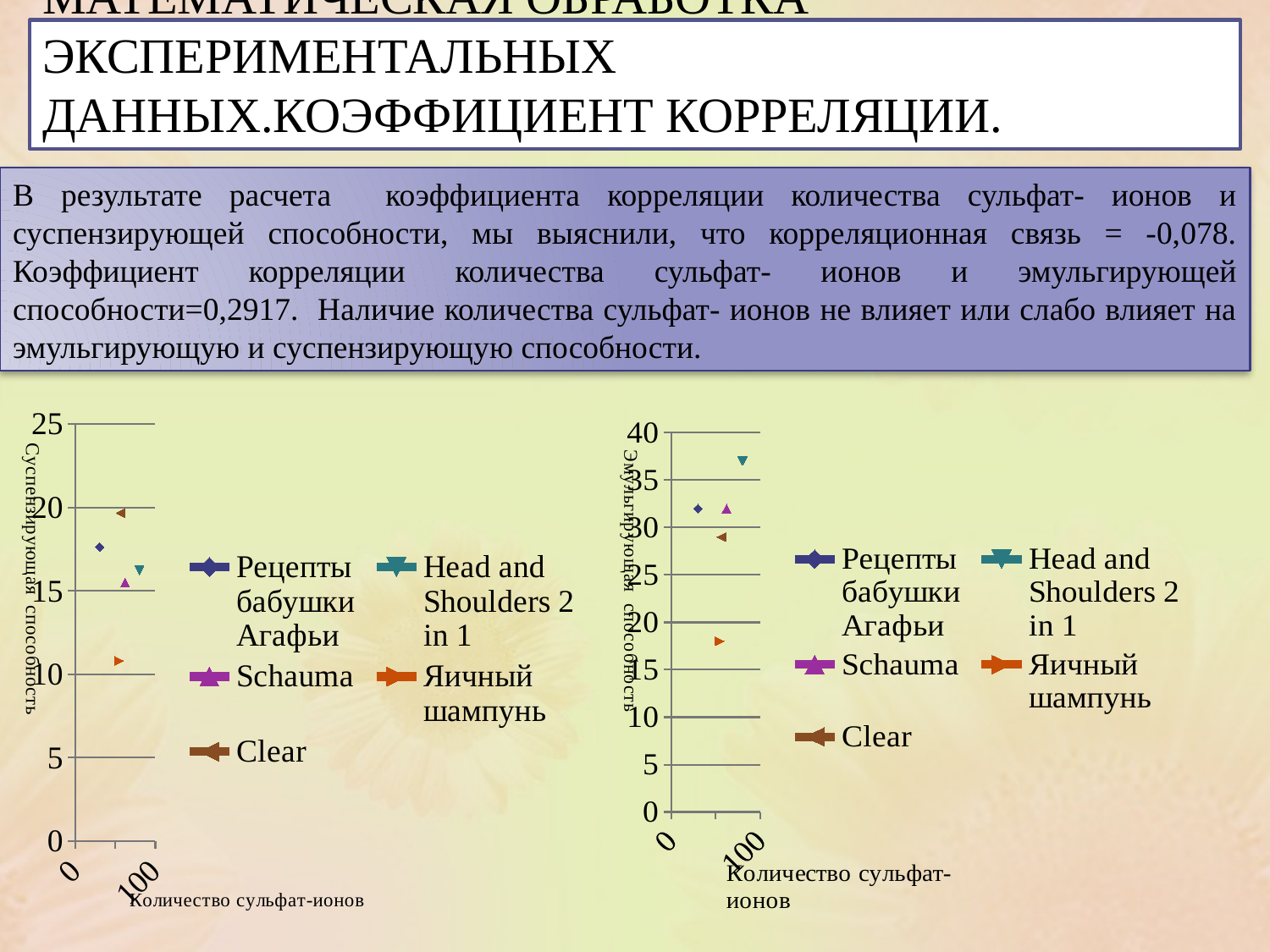
In the right chart (Эмульгирующая способность), which shampoo has the highest value? Head and Shoulders 2 in 1 What kind of chart is the left chart on the slide? scatter chart In the left chart, is the value for Яичный шампунь greater or less than 15? less In the right chart (Эмульгирующая способность), which shampoo has the lowest value? Яичный шампунь How many series does the legend of the right chart list? 5 In the left chart (Суспензирующая способность), which shampoo has the lowest value? Яичный шампунь In the right chart, which is larger: the value for Head and Shoulders 2 in 1 or the value for Clear? Head and Shoulders 2 in 1 In the left chart (Суспензирующая способность), which shampoo has the highest value? Clear In the right chart, is the value for Яичный шампунь greater or less than 20? less In the right chart, is the value for Head and Shoulders 2 in 1 greater or less than 35? greater What is the y-axis label of the right chart? Эмульгирующая способность